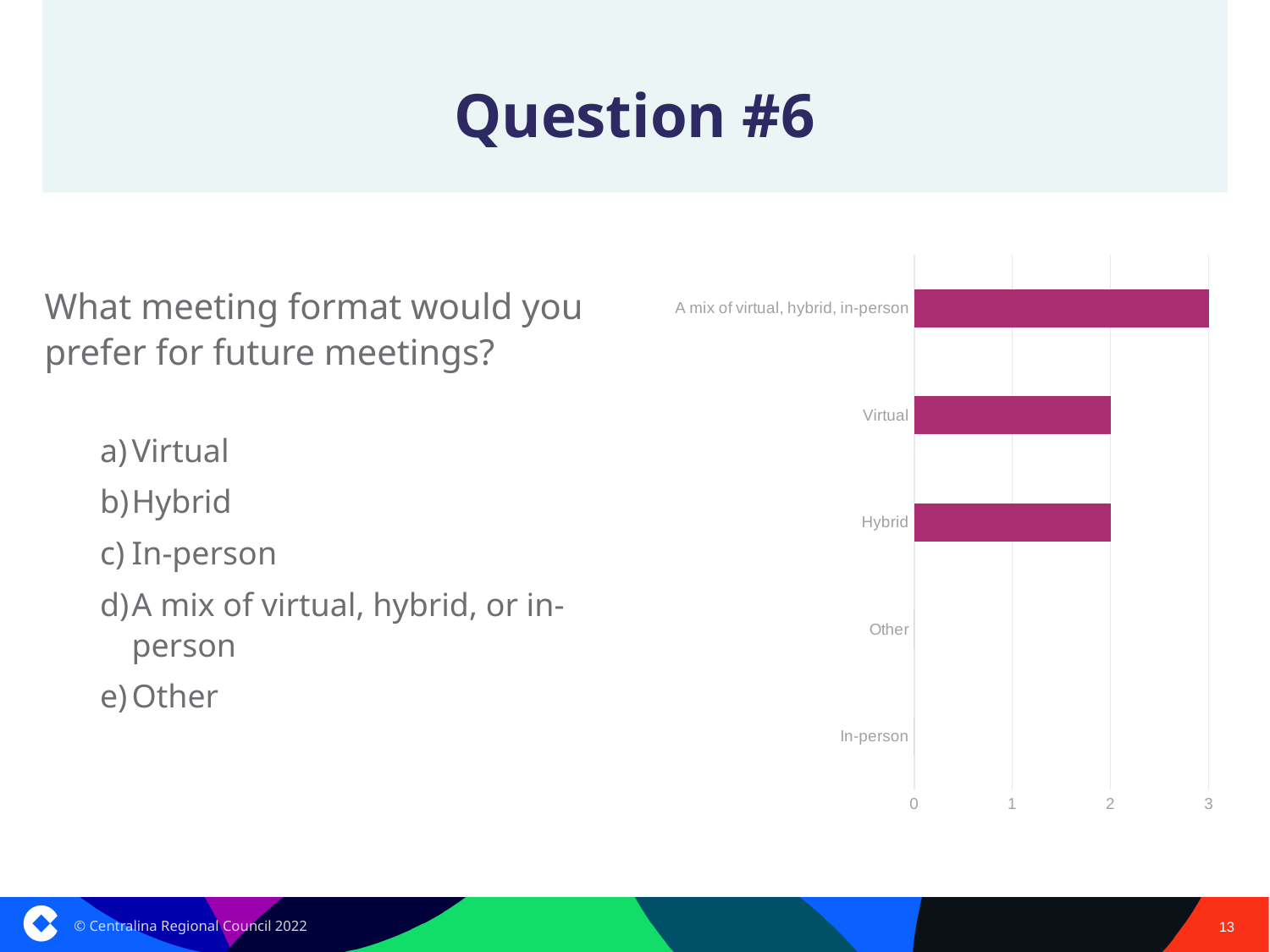
Is the value for "A mix of virtual, hybrid, in-person" greater or less than 2? greater What is the value for "Hybrid" in the chart? 2 What kind of chart is shown on the slide? bar chart What is the value for "A mix of virtual, hybrid, in-person" in the chart? 3 What colour are the bars in the chart? magenta What is the value for "In-person" in the chart? 0 What is the highest value shown on the chart's horizontal axis? 3 What is the value for "Virtual" in the chart? 2 How many categories are shown in the chart? 5 What is the difference between the values for "A mix of virtual, hybrid, in-person" and "Virtual"? 1 Which category has the highest value in the chart? A mix of virtual, hybrid, in-person Which is larger, the value for "Hybrid" or the value for "Other"? Hybrid